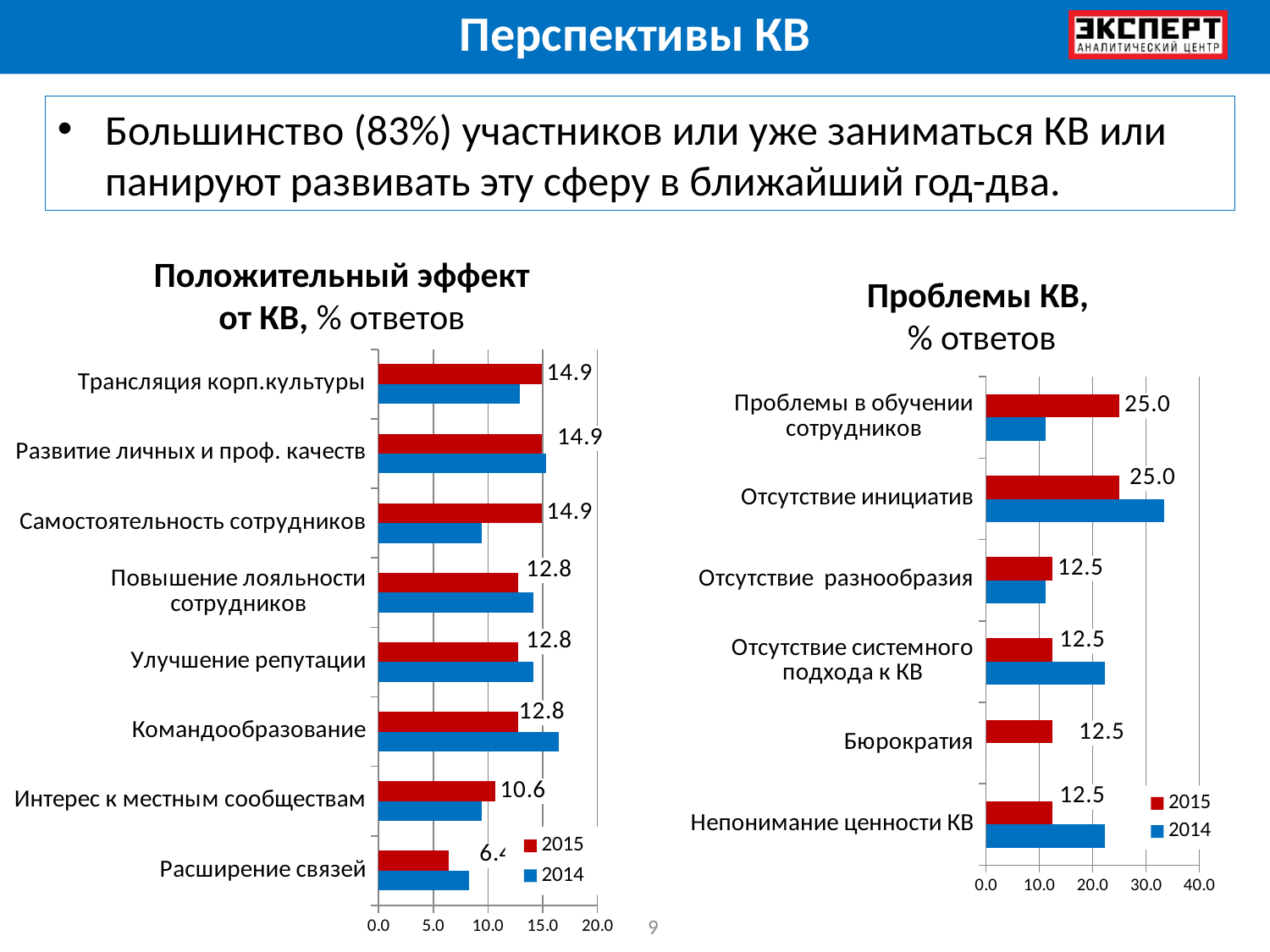
In the left chart "Положительный эффект от КВ", how many categories are shown? 8 In the right chart "Проблемы КВ", what is the 2015 value for "Бюрократия"? 12.5 In the left chart "Положительный эффект от КВ", what is the difference between the 2015 values for "Самостоятельность сотрудников" and "Интерес к местным сообществам"? 4.3 In the right chart "Проблемы КВ", how many categories are shown? 6 In the right chart "Проблемы КВ", what is the 2015 value for "Проблемы в обучении сотрудников"? 25.0 In the right chart "Проблемы КВ", is the 2014 value for "Отсутствие инициатив" greater or less than 30.0? greater In the right chart "Проблемы КВ", what is the difference between the 2015 values for "Отсутствие инициатив" and "Непонимание ценности КВ"? 12.5 In the right chart "Проблемы КВ", how many series does the legend list? 2 In the left chart "Положительный эффект от КВ", what is the 2015 value for "Интерес к местным сообществам"? 10.6 In the left chart "Положительный эффект от КВ", which is larger for "Командообразование": the 2014 value or the 2015 value? 2014 In the left chart "Положительный эффект от КВ", what is the 2015 value for "Трансляция корп.культуры"? 14.9 What kind of chart is the left chart titled "Положительный эффект от КВ, % ответов"? bar chart